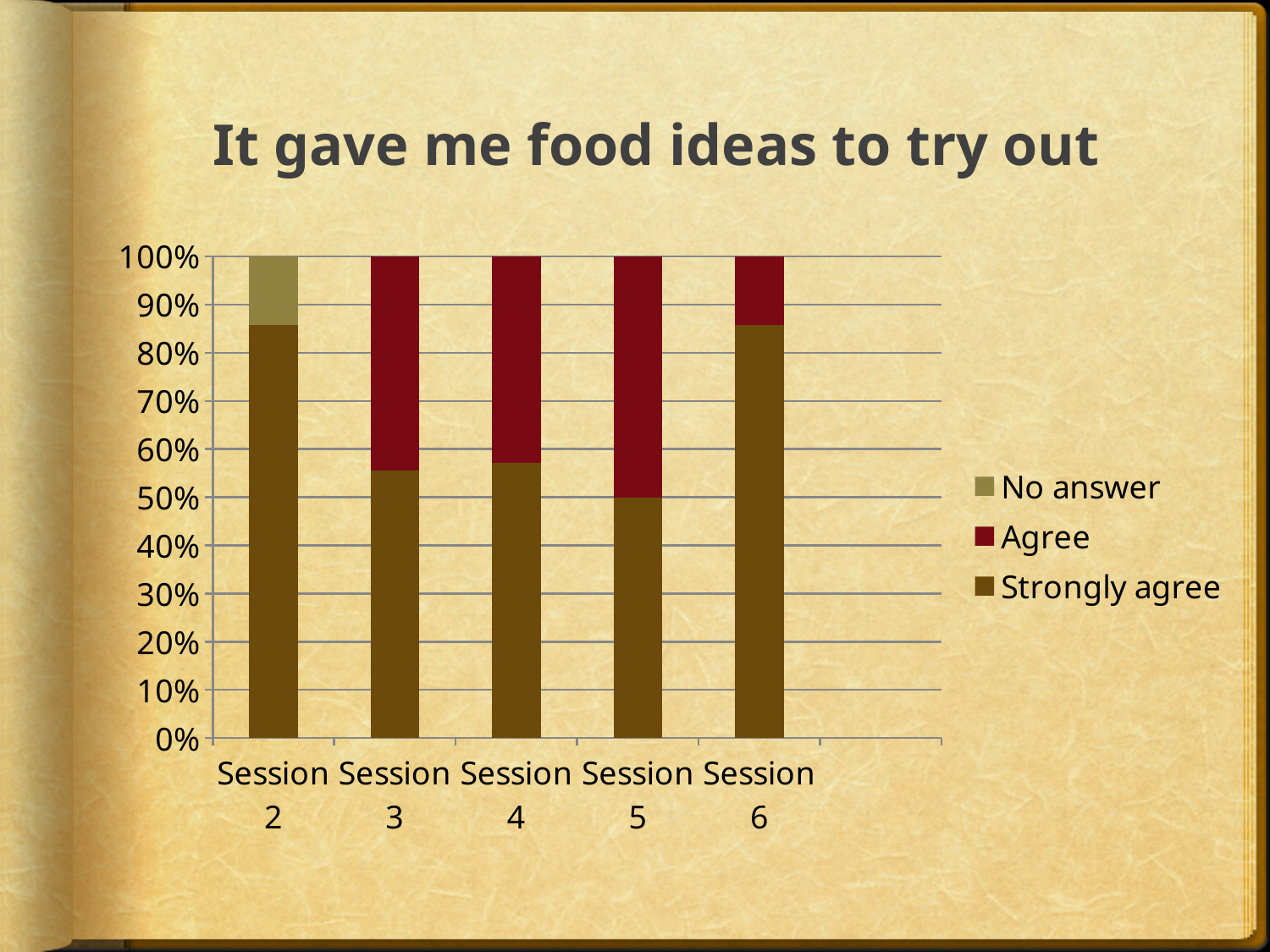
Is the 'Strongly agree' value for Session 6 greater or less than 80%? greater What is the title of the chart? It gave me food ideas to try out Is the 'Strongly agree' value for Session 2 greater or less than 80%? greater Which has a larger 'Strongly agree' share, Session 3 or Session 6? Session 6 Which session has the largest 'Agree' share? Session 5 How many series does the chart's legend list? 3 Which session has the lowest 'Strongly agree' share? Session 5 Is the 'Agree' value for Session 4 greater or less than 40%? greater Which session is the only one with a 'No answer' segment? Session 2 How many sessions are shown on the x axis of the chart? 5 What kind of chart is shown on the slide? Stacked bar chart